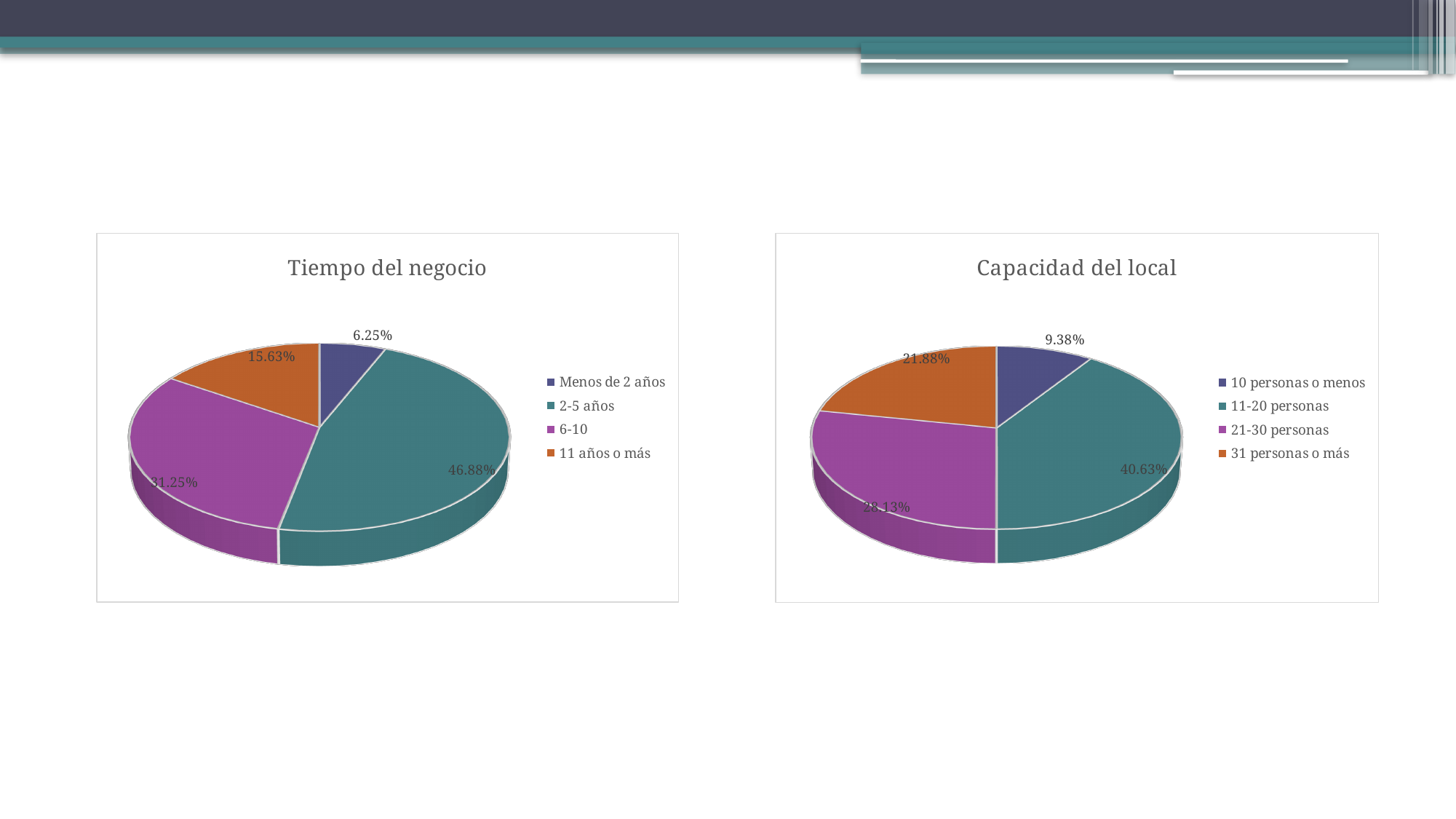
What type of chart is 'Capacidad del local'? Pie chart In the 'Tiempo del negocio' chart, which category has the smallest slice? Menos de 2 años In the 'Capacidad del local' chart, what share does '31 personas o más' have? 21.88% In the 'Tiempo del negocio' chart, what is the difference between the '6-10' and '11 años o más' shares? 15.62% In the 'Capacidad del local' chart, what share does '21-30 personas' have? 28.13% In the 'Tiempo del negocio' chart, how many categories does the legend list? 4 In the 'Capacidad del local' chart, which category has the largest slice? 11-20 personas In the 'Capacidad del local' chart, which is larger, '21-30 personas' or '31 personas o más'? 21-30 personas In the 'Tiempo del negocio' chart, which category has the largest slice? 2-5 años In the 'Tiempo del negocio' chart, what share does '2-5 años' have? 46.88% In the 'Tiempo del negocio' chart, what share does 'Menos de 2 años' have? 6.25% In the 'Capacidad del local' chart, what is the difference between the '11-20 personas' and '10 personas o menos' shares? 31.25%